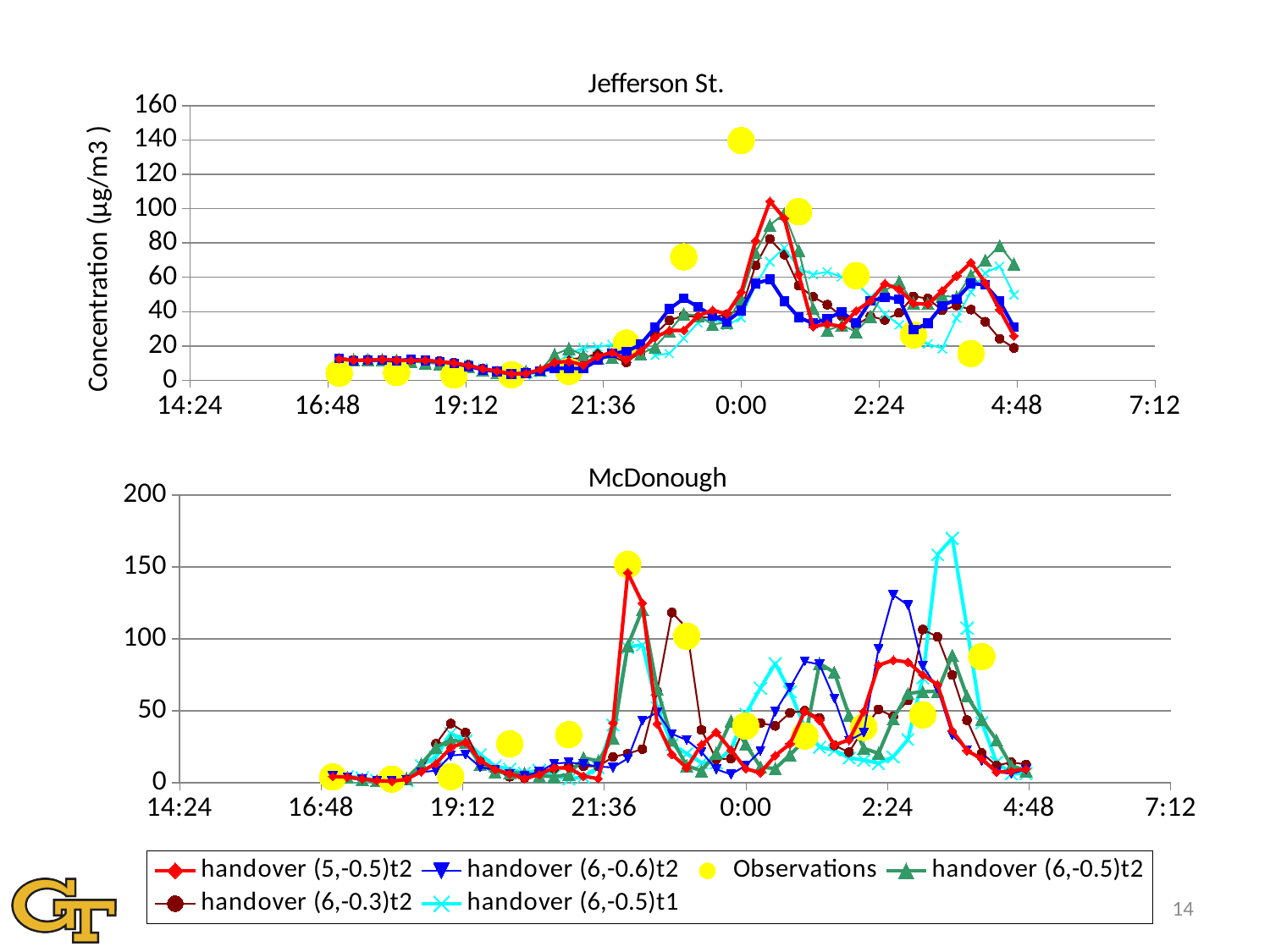
How many series does the legend list for the charts? 6 What is the title of the top chart? Jefferson St. In the Jefferson St. chart, is the Observations value at 16:48 greater or less than 20? less What kind of chart is the Jefferson St. chart? line chart In the McDonough chart, is the peak of handover (5,-0.5)t2 near 21:50 greater or less than 100? greater In the Jefferson St. chart, do the series values generally rise or fall between 21:36 and 0:00? rise In the Jefferson St. chart, which series reaches the highest value? Observations In the McDonough chart, is the peak of handover (6,-0.5)t1 (around 3:20) greater or less than 150? greater In the Jefferson St. chart, at 0:00, which is larger: the Observations value or the handover (5,-0.5)t2 value? Observations What is the y-axis label on the Jefferson St. chart? Concentration (µg/m3) In the McDonough chart, which series reaches the highest value? handover (6,-0.5)t1